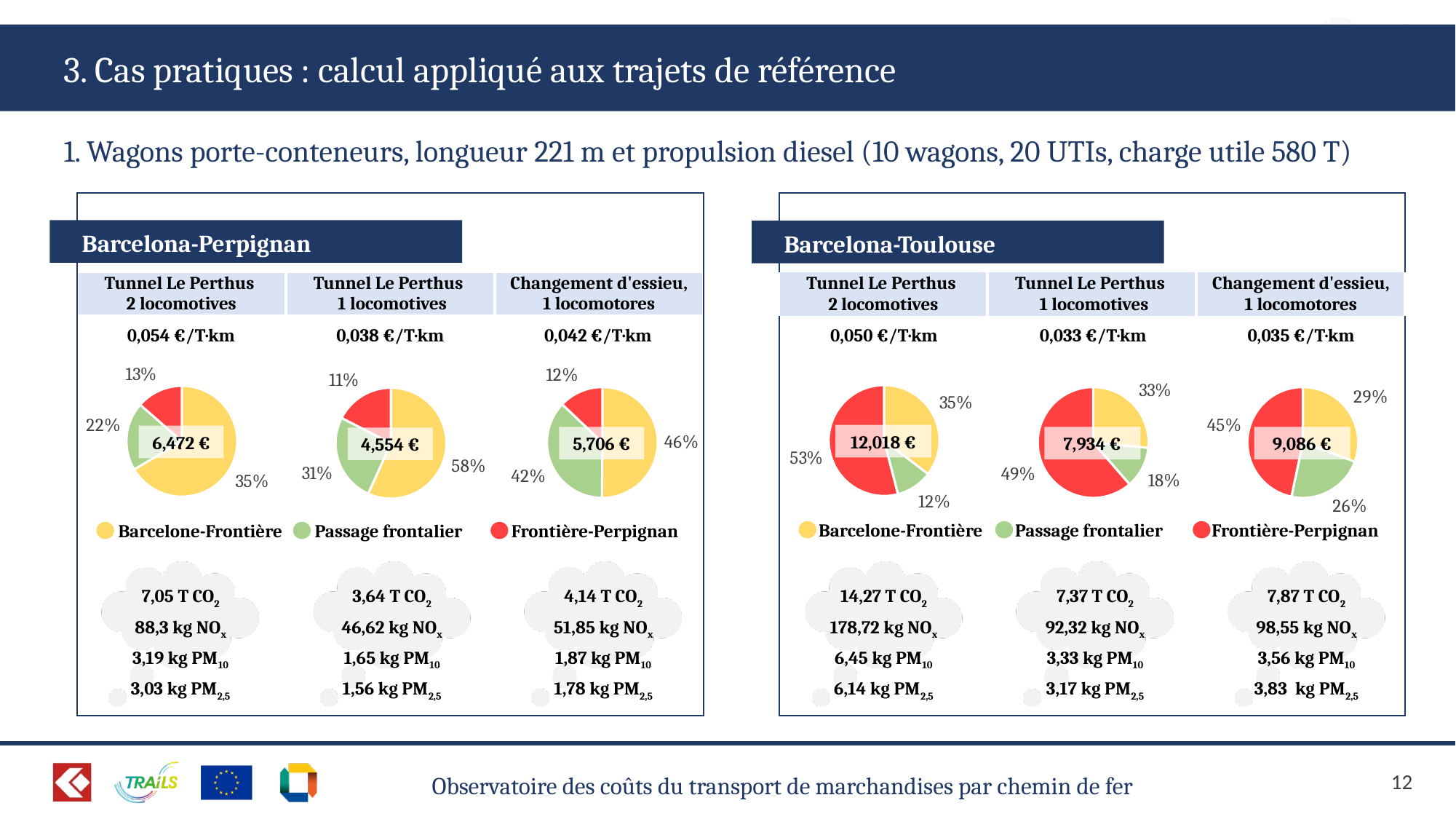
Which colour represents Passage frontalier in the pie charts? Green In the Barcelona-Toulouse "Tunnel Le Perthus 1 locomotives" pie, what share is Frontière-Perpignan? 49% In the Barcelona-Toulouse "Changement d'essieu, 1 locomotores" pie, which is larger: Barcelone-Frontière or Passage frontalier? Barcelone-Frontière How many slices does each pie chart on the slide have? 3 In the Barcelona-Perpignan "Tunnel Le Perthus 1 locomotives" pie, which segment is the largest? Barcelone-Frontière In the Barcelona-Toulouse "Tunnel Le Perthus 2 locomotives" pie, which segment is the smallest? Passage frontalier What kind of chart is used under "Tunnel Le Perthus 1 locomotives" in the Barcelona-Perpignan panel? Pie chart How many entries does the legend list in the Barcelona-Toulouse panel? 3 In the Barcelona-Perpignan "Changement d'essieu, 1 locomotores" pie, what is the difference between the Barcelone-Frontière share and the Passage frontalier share? 4% In the Barcelona-Toulouse panel, what total cost is shown in the centre of the "Tunnel Le Perthus 2 locomotives" pie? 12,018 € In the Barcelona-Perpignan "Changement d'essieu, 1 locomotores" pie, what share is Passage frontalier? 42% In the Barcelona-Perpignan panel, what total cost is shown in the centre of the "Tunnel Le Perthus 1 locomotives" pie? 4,554 €